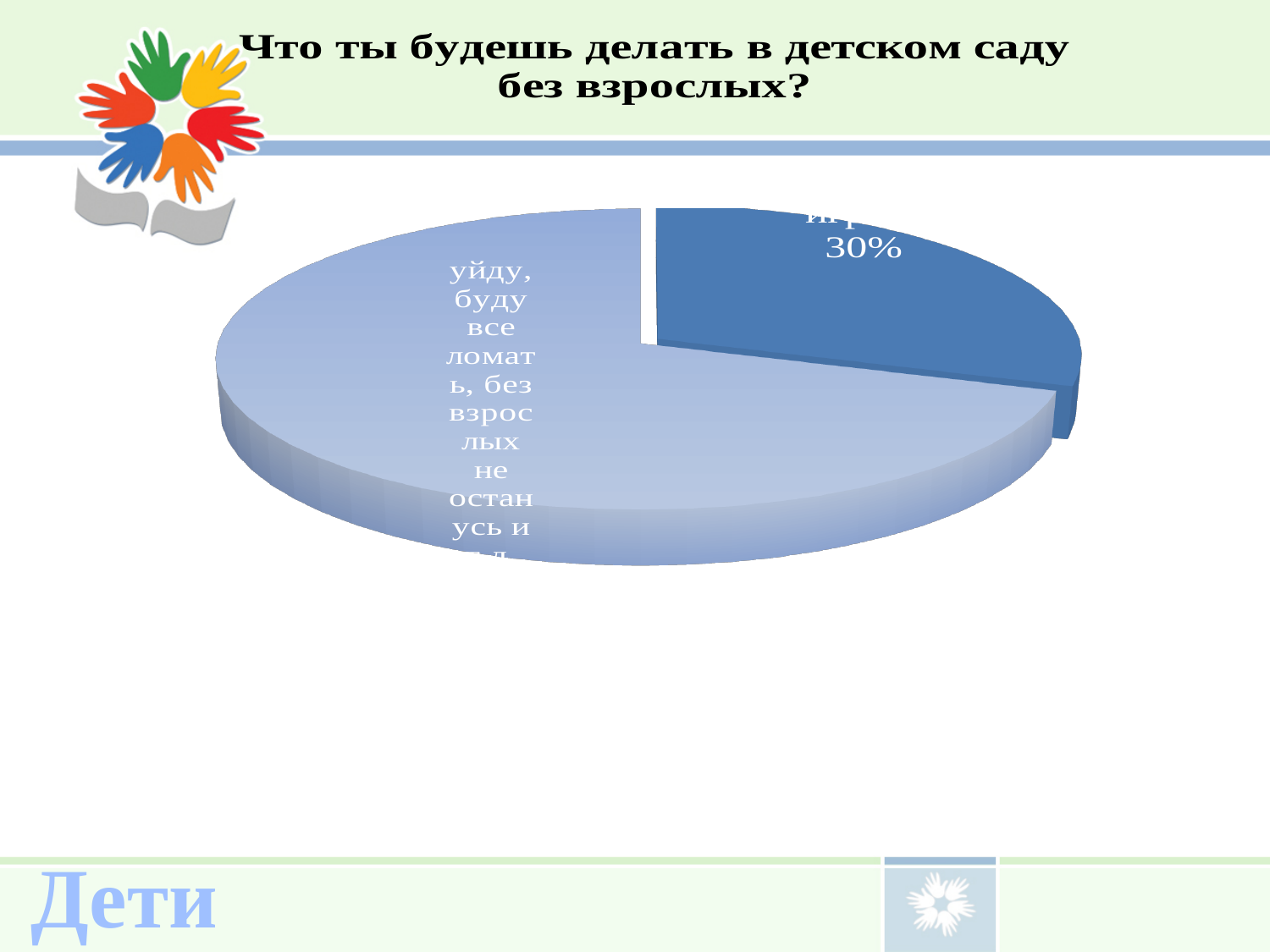
What percentage is printed on the dark blue slice of the pie chart? 30% Which slice of the pie chart is the largest? the light blue slice ("уйду, буду все ломать...") What colour is the slice of the pie chart that shows 30%? dark blue How many slices does the pie chart have? 2 Which slice of the pie chart is larger: the dark blue slice labelled 30% or the light blue slice labelled "уйду, буду все ломать..."? the light blue slice ("уйду, буду все ломать...") What is the title of the slide above the pie chart? Что ты будешь делать в детском саду без взрослых? Which slice of the pie chart is the smallest? the dark blue slice (30%) What kind of chart is shown on the slide? pie chart